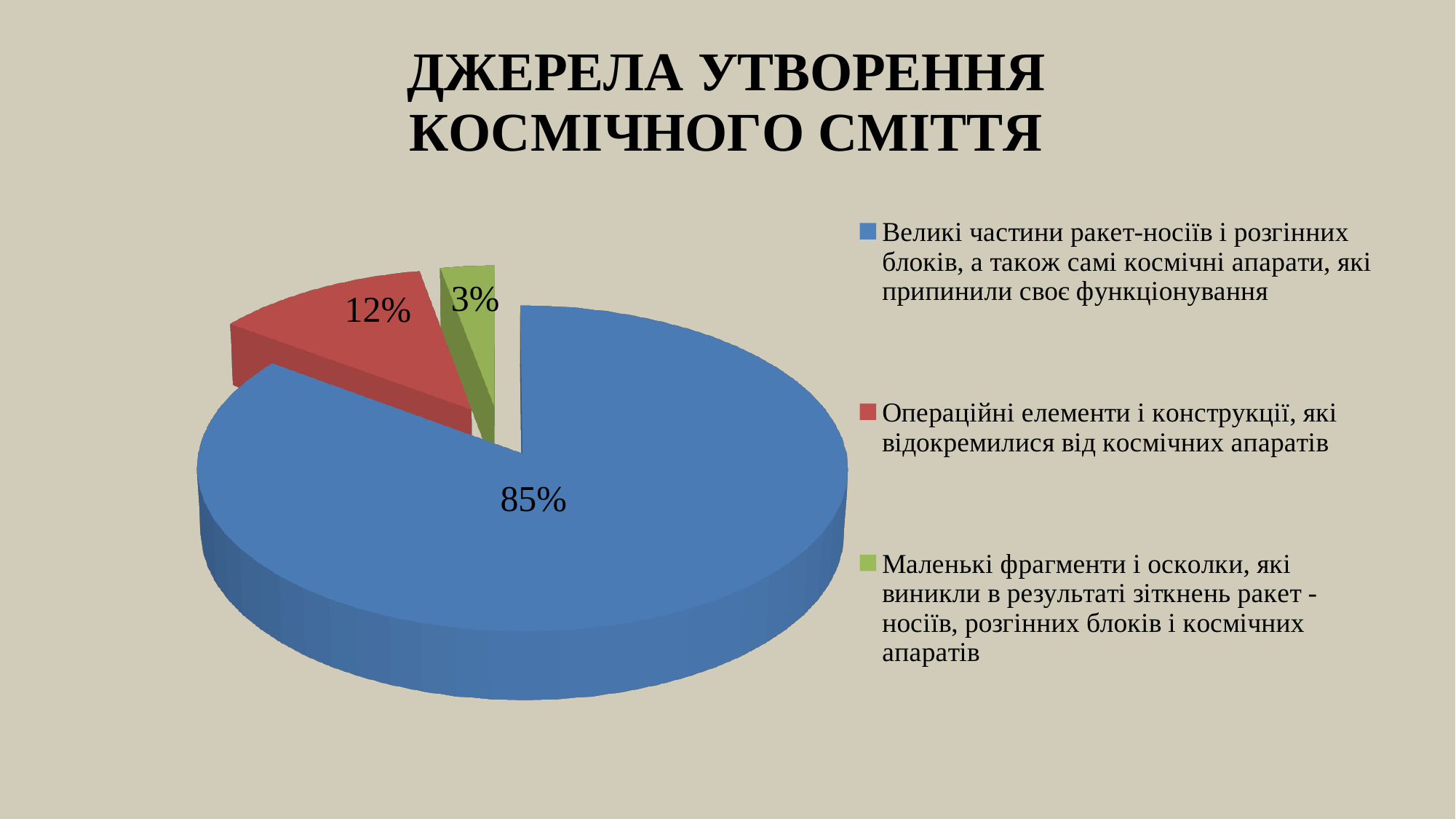
Which category has the largest slice of the pie? Великі частини ракет-носіїв і розгінних блоків, а також самі космічні апарати, які припинили своє функціонування What share of the pie is labelled for 'Маленькі фрагменти і осколки, які виникли в результаті зіткнень ракет-носіїв, розгінних блоків і космічних апаратів'? 3% Which is larger: the slice for 'Операційні елементи і конструкції' or the slice for 'Маленькі фрагменти і осколки'? Операційні елементи і конструкції Which category has the smallest slice of the pie? Маленькі фрагменти і осколки, які виникли в результаті зіткнень ракет-носіїв, розгінних блоків і космічних апаратів How many slices does the pie chart have? 3 What kind of chart is shown on the slide? pie chart What colour is the slice labelled 85%? blue What is the title of the slide? ДЖЕРЕЛА УТВОРЕННЯ КОСМІЧНОГО СМІТТЯ What share of the pie is labelled for 'Великі частини ракет-носіїв і розгінних блоків, а також самі космічні апарати, які припинили своє функціонування'? 85% What is the difference in percentage points between the largest slice (85%) and the 12% slice? 73 What share of the pie is labelled for 'Операційні елементи і конструкції, які відокремилися від космічних апаратів'? 12% What is the difference in percentage points between the 12% slice and the 3% slice? 9